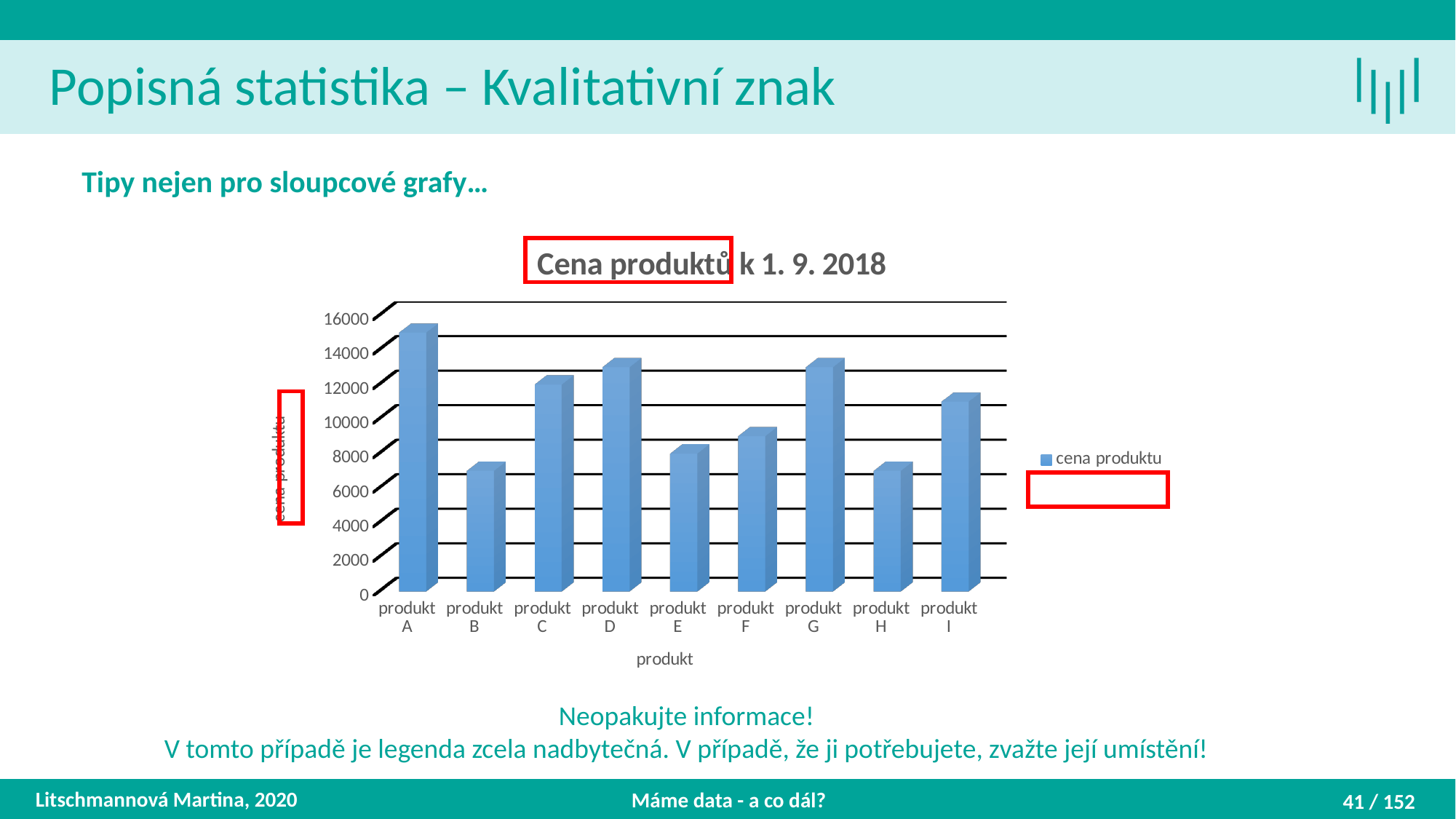
Which product has the highest price in the chart? produkt A Which has the larger value, produkt H or produkt I? produkt I Is the value for produkt A greater or less than 14000? greater How many products are shown on the x axis of the chart? 9 Which has the larger value, produkt C or produkt E? produkt C Is the value for produkt B greater or less than 8000? less What is the legend entry of the chart? cena produktu What is the title of the chart? Cena produktů k 1. 9. 2018 Is the value for produkt G greater or less than 12000? greater What type of chart is shown on the slide? bar chart How many series does the chart legend list? 1